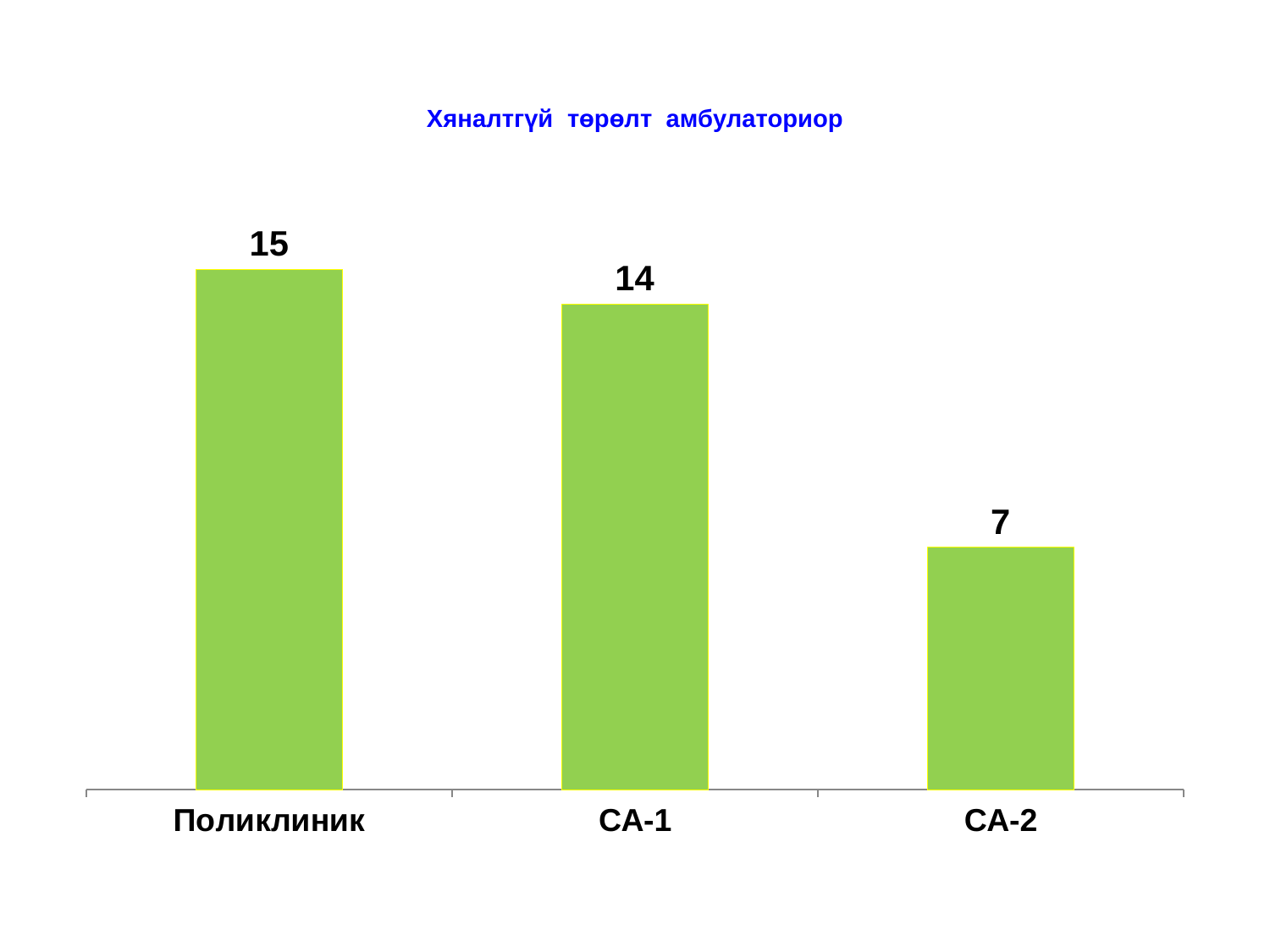
What is the difference between the values for Поликлиник and СА-2? 8 What is the value for СА-1? 14 What kind of chart is shown on the slide? bar chart What is the title of the chart? Хяналтгүй төрөлт амбулаториор Which is larger, the value for СА-1 or the value for СА-2? СА-1 What is the value for СА-2? 7 What is the value for Поликлиник? 15 How many categories are shown on the chart? 3 Which category has the highest value? Поликлиник Do the values rise or fall from left to right across the categories? fall What is the difference between the values for СА-1 and СА-2? 7 Which category has the lowest value? СА-2